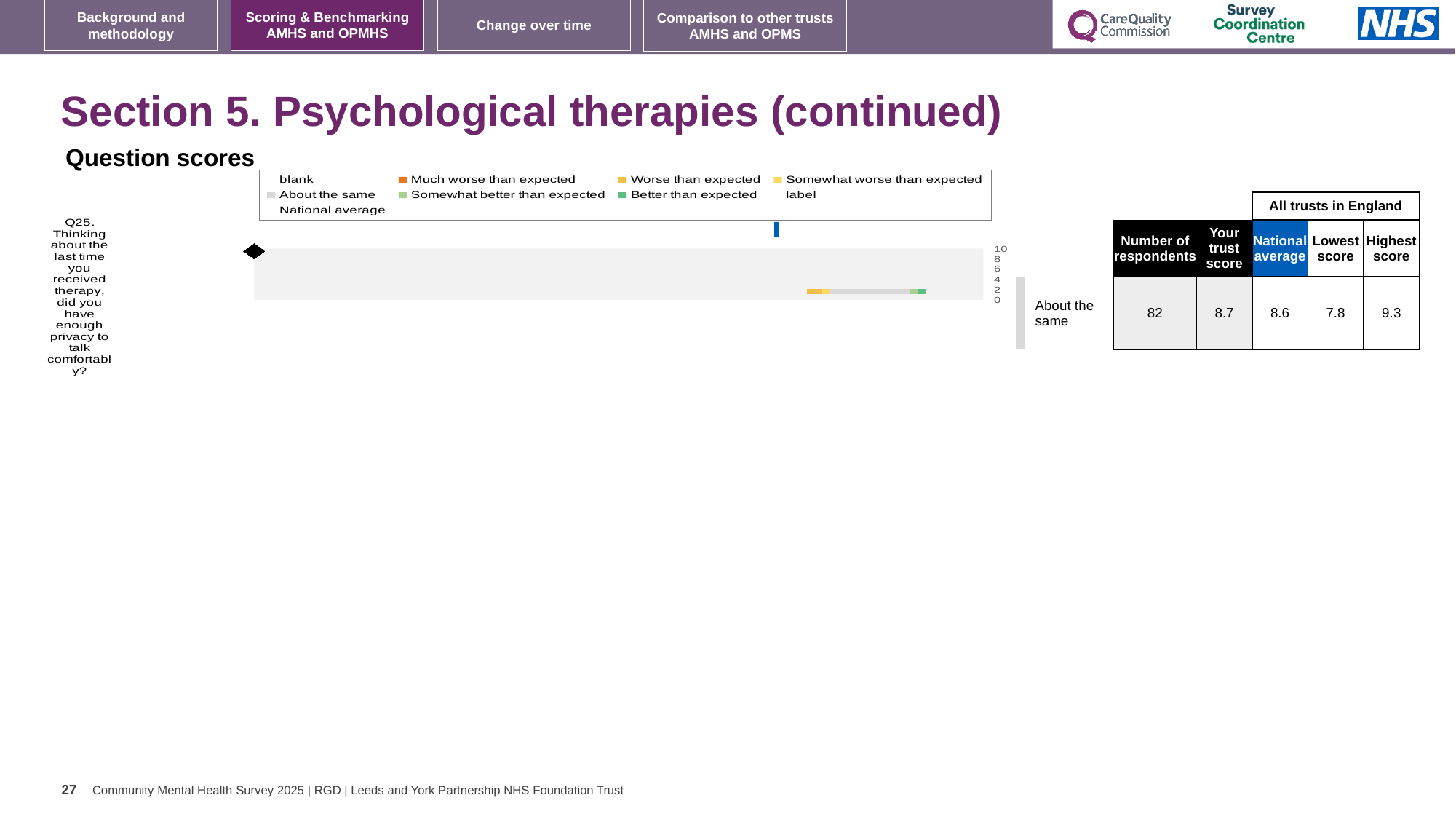
According to the table, which is larger for Q25: your trust score or the national average? Your trust score In the table next to the chart, what is the highest score among all trusts in England for Q25? 9.3 What benchmark label is shown next to the bar for Q25? About the same What kind of chart is shown under 'Question scores'? bar chart In the table next to the chart, what is the national average for Q25? 8.6 In the table next to the chart, what is 'Your trust score' for Q25? 8.7 Which question number is plotted in the chart? Q25 How many questions (categories) are plotted in the chart? 1 In the table next to the chart, what is the number of respondents for Q25? 82 In the table next to the chart, what is the lowest score among all trusts in England for Q25? 7.8 What is the highest tick value shown on the chart's axis? 10 According to the table, what is the difference between the highest score and the lowest score for Q25? 1.5